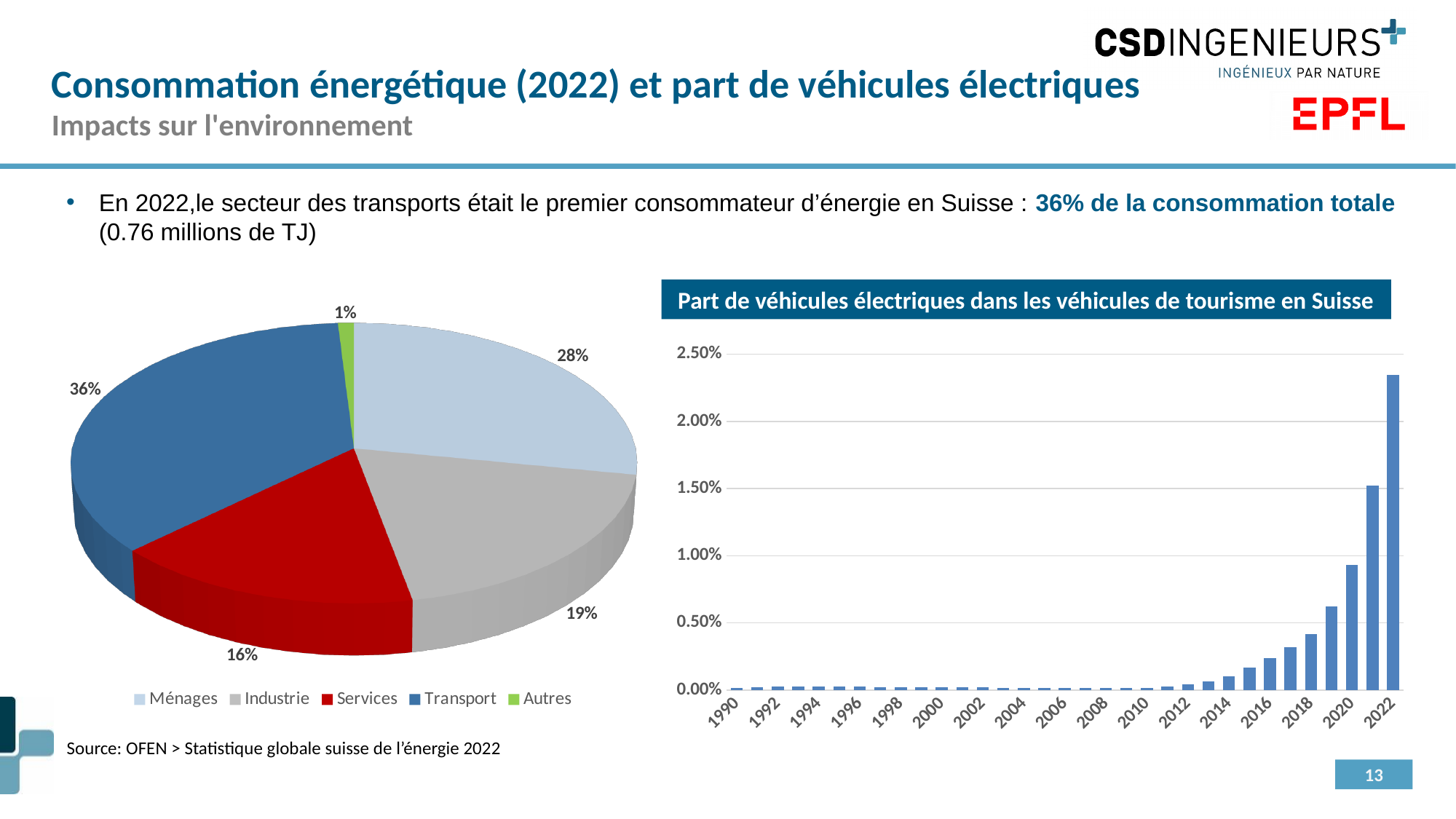
In the pie chart on the left, what is the difference in percentage points between Transport and Services? 20 In the chart 'Part de véhicules électriques dans les véhicules de tourisme en Suisse', is the value for 2020 greater or less than 1.00%? less In the chart 'Part de véhicules électriques dans les véhicules de tourisme en Suisse', is the value for 2022 greater or less than 2.00%? greater What kind of chart is the chart on the right, 'Part de véhicules électriques dans les véhicules de tourisme en Suisse'? Bar chart In the chart 'Part de véhicules électriques dans les véhicules de tourisme en Suisse', do the values rise or fall from 1990 to 2022? Rise How many categories does the legend of the pie chart on the left list? 5 In the pie chart on the left, what share does Transport have? 36% In the pie chart on the left, which is larger, Industrie or Services? Industrie In the pie chart on the left, which category has the smallest share? Autres In the pie chart on the left, which category has the largest share? Transport In the pie chart on the left, what share does Ménages have? 28% In the pie chart on the left, what share does Industrie have? 19%